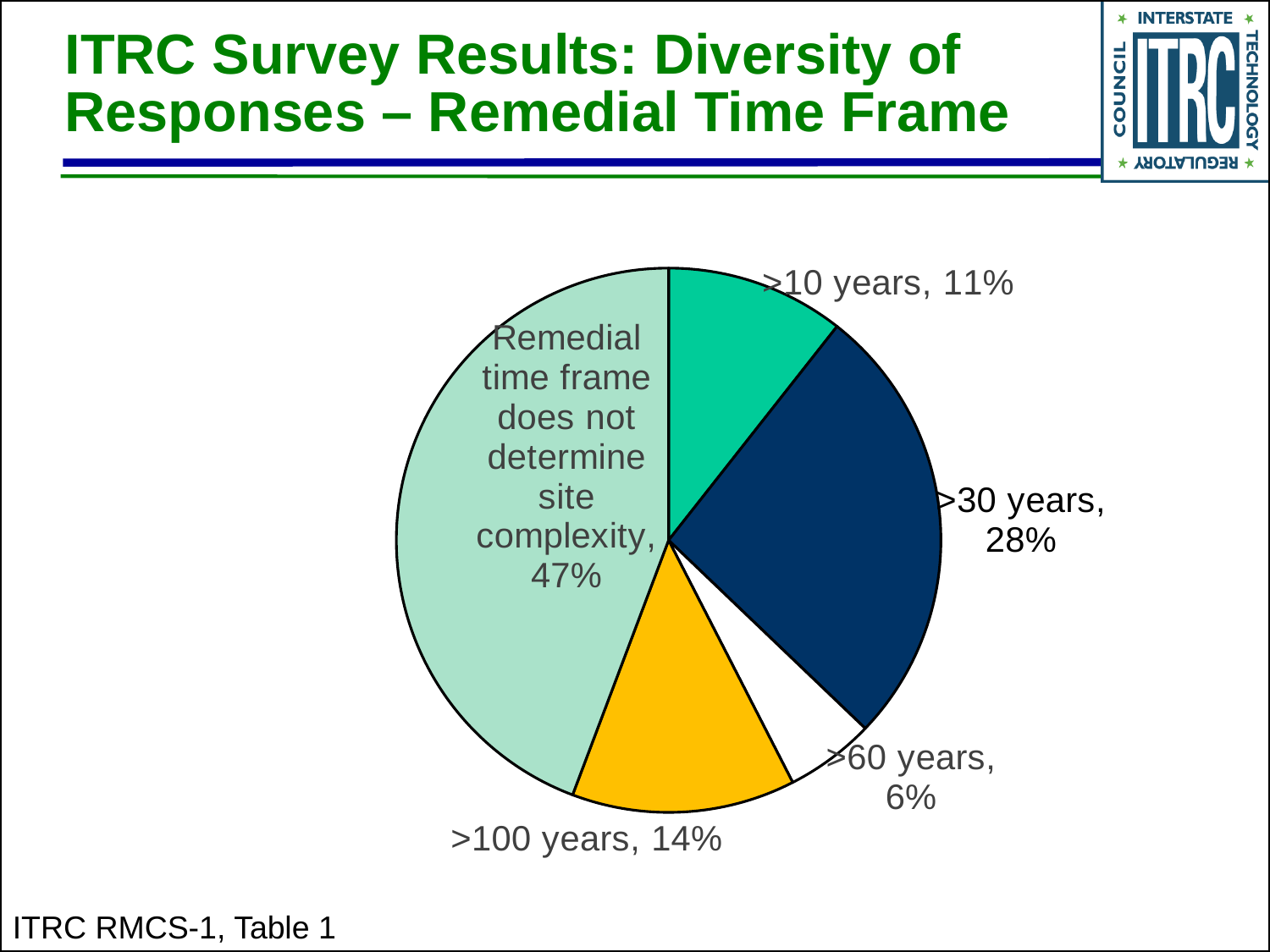
What kind of chart is shown on the slide? pie chart Which category has the smallest slice of the pie? >60 years What share of responses is for '>100 years'? 14% How many slices does the pie chart have? 5 What is the difference in percentage points between '>30 years' and '>10 years'? 17 What share of responses says remedial time frame does not determine site complexity? 47% Which category has the largest slice of the pie? Remedial time frame does not determine site complexity Which is larger, the share for '>100 years' or the share for '>60 years'? >100 years What share of responses is for '>30 years'? 28% What source is cited below the chart? ITRC RMCS-1, Table 1 What share of responses is for '>60 years'? 6% What share of responses is for '>10 years'? 11%